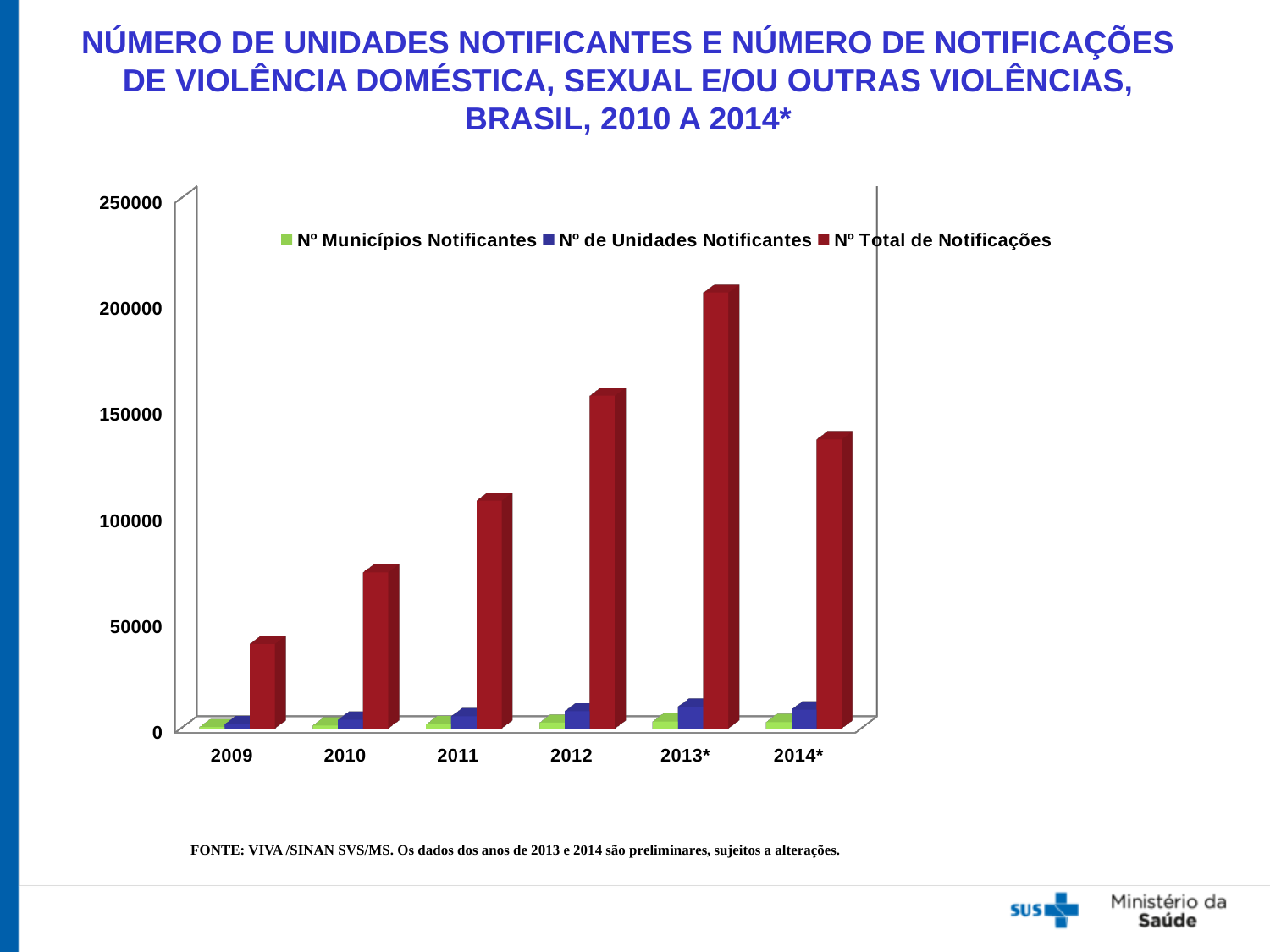
Does Nº Total de Notificações rise or fall from 2009 to 2013*? rise Which is larger, Nº Total de Notificações in 2012 or in 2014*? 2012 Is the value for Nº Total de Notificações in 2011 greater or less than 100000? greater How many series does the legend list? 3 Which series is shown in green in the legend? Nº Municípios Notificantes What kind of chart is shown on the slide? bar chart Is the value for Nº Total de Notificações in 2012 greater or less than 150000? greater Is the value for Nº Total de Notificações in 2014* greater or less than 150000? less Which year has the highest value for Nº Total de Notificações? 2013* Which year has the lowest value for Nº Total de Notificações? 2009 How many years are shown on the x axis? 6